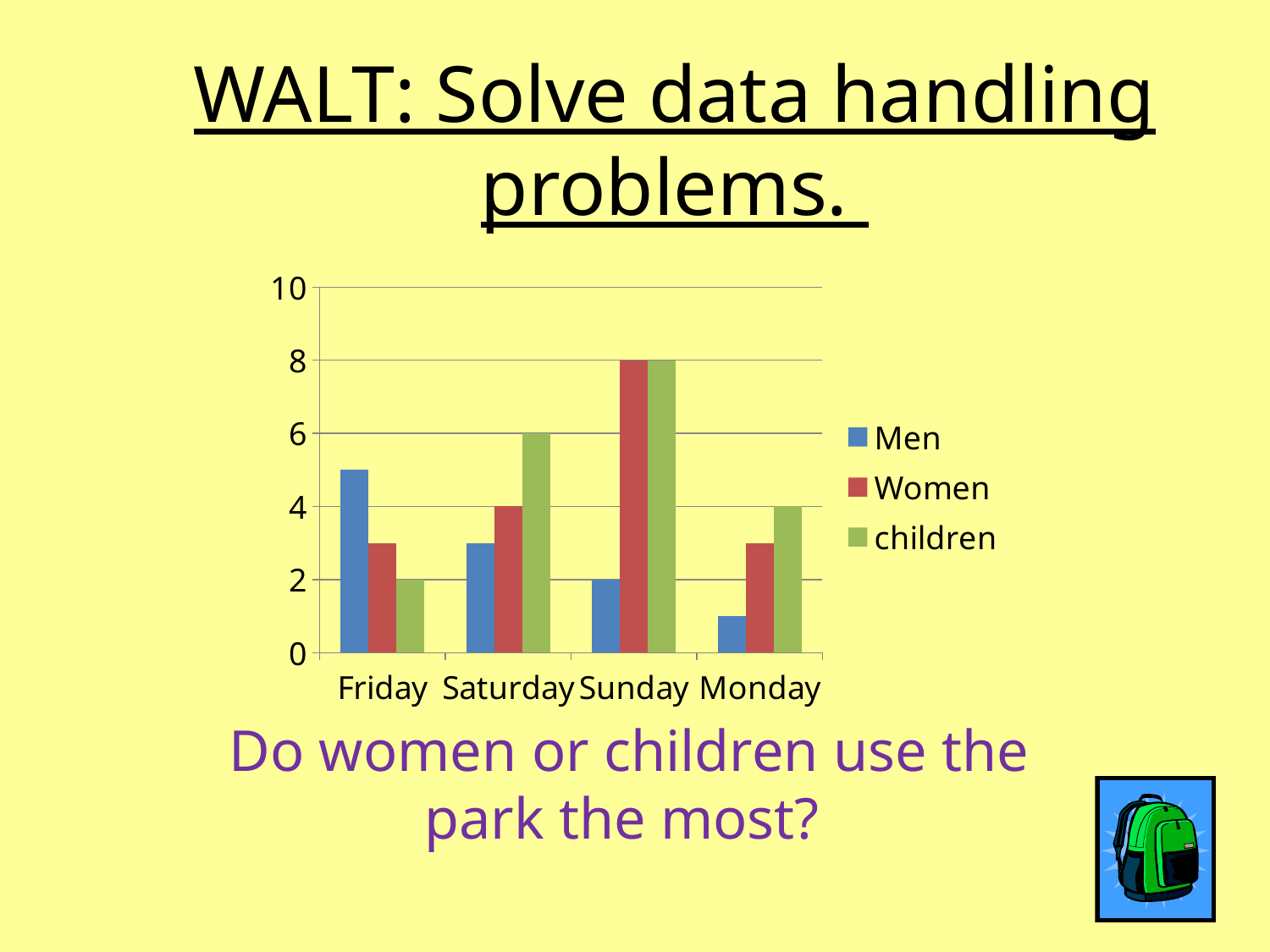
What is the value for Men on Sunday? 2 What is the value for children on Monday? 4 Which is larger on Saturday, the value for Men or the value for children? children What is the value for Women on Sunday? 8 Is the value for Men on Monday greater or less than 2? less What kind of chart is shown on the slide? bar chart On which day is the value for children the lowest? Friday How many series does the legend list? 3 Is the value for Men on Friday greater or less than 4? greater On which day is the value for Men the highest? Friday How many days are shown on the x axis? 4 What is the value for children on Saturday? 6